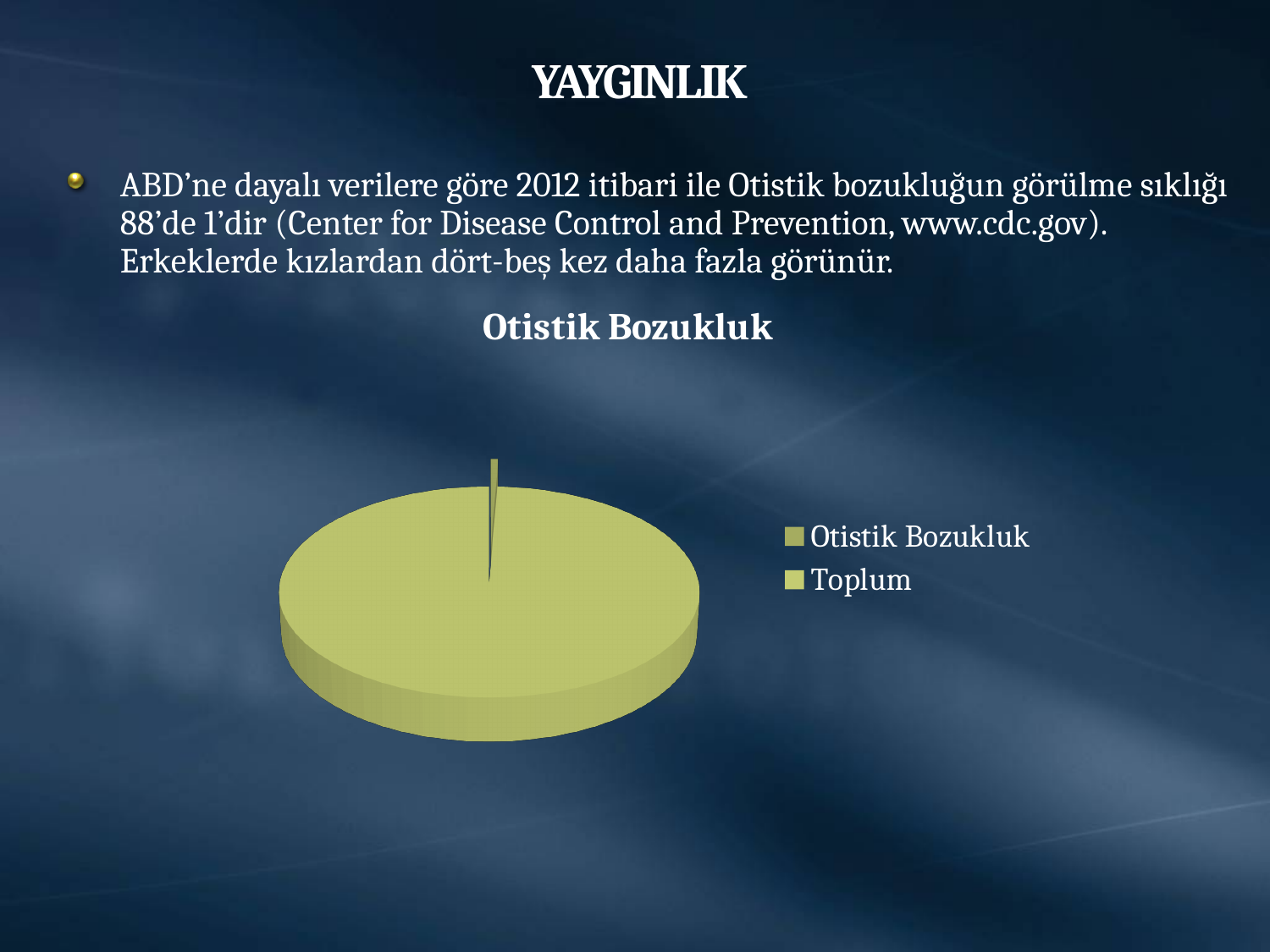
Which slice is larger, Otistik Bozukluk or Toplum? Toplum Which category has the largest slice of the pie? Toplum What are the two categories listed in the chart's legend? Otistik Bozukluk and Toplum How many slices does the pie chart have? 2 What is the title of the chart? Otistik Bozukluk How many entries does the chart's legend list? 2 What kind of chart is shown on the slide? pie chart Which category has the smallest slice of the pie? Otistik Bozukluk